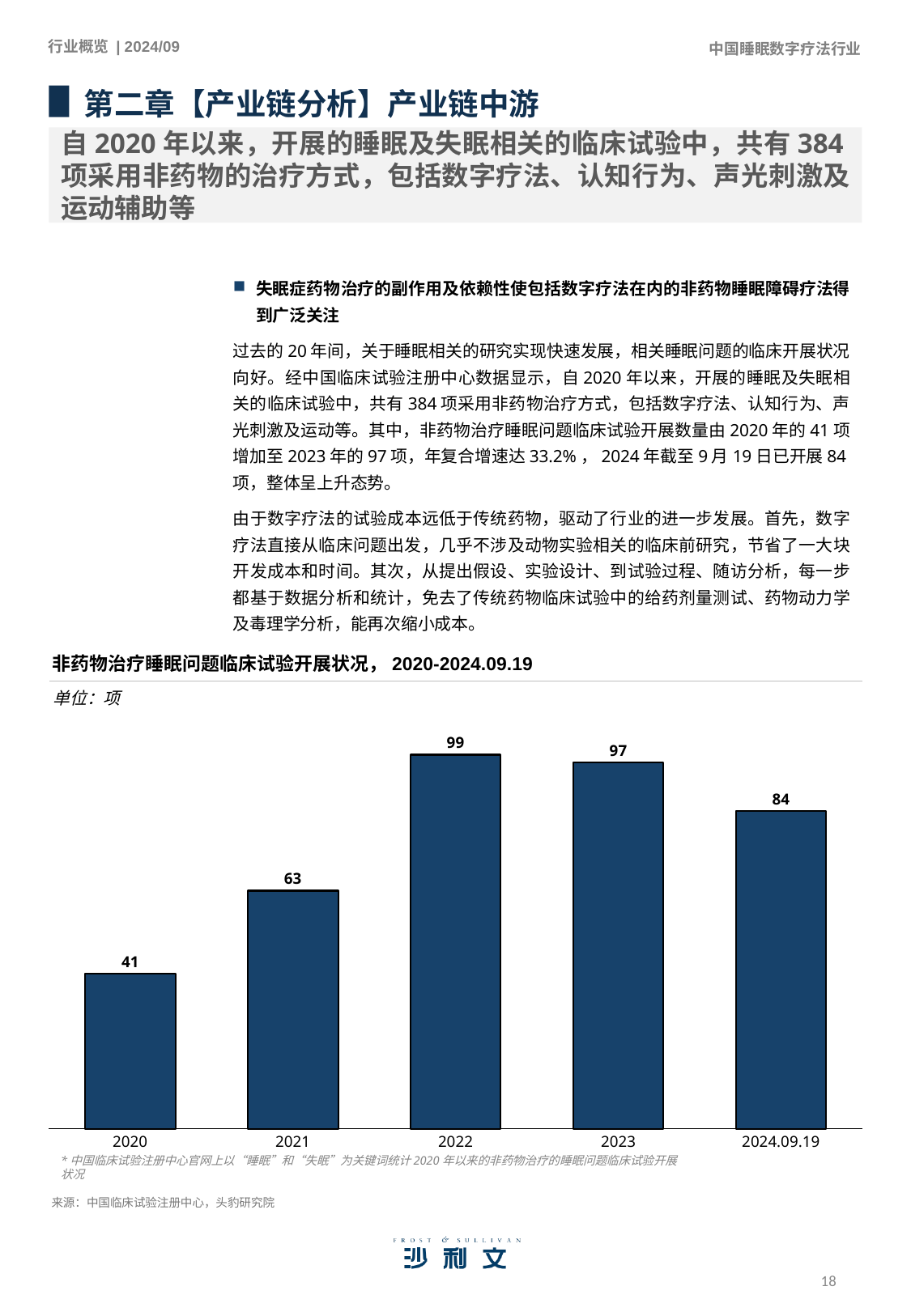
How many categories are shown on the x axis? 5 What is the difference between the values for 2023 and 2020? 56 What unit is stated for the chart? 项 Which is larger, the value for 2021 or the value for 2024.09.19? 2024.09.19 Do the values rise or fall from 2020 to 2022? rise Which category has the highest value? 2022 What is the value for 2020? 41 What kind of chart is this? bar chart Which category has the lowest value? 2020 What is the difference between the values for 2022 and 2021? 36 What is the value for 2024.09.19? 84 What is the value for 2022? 99